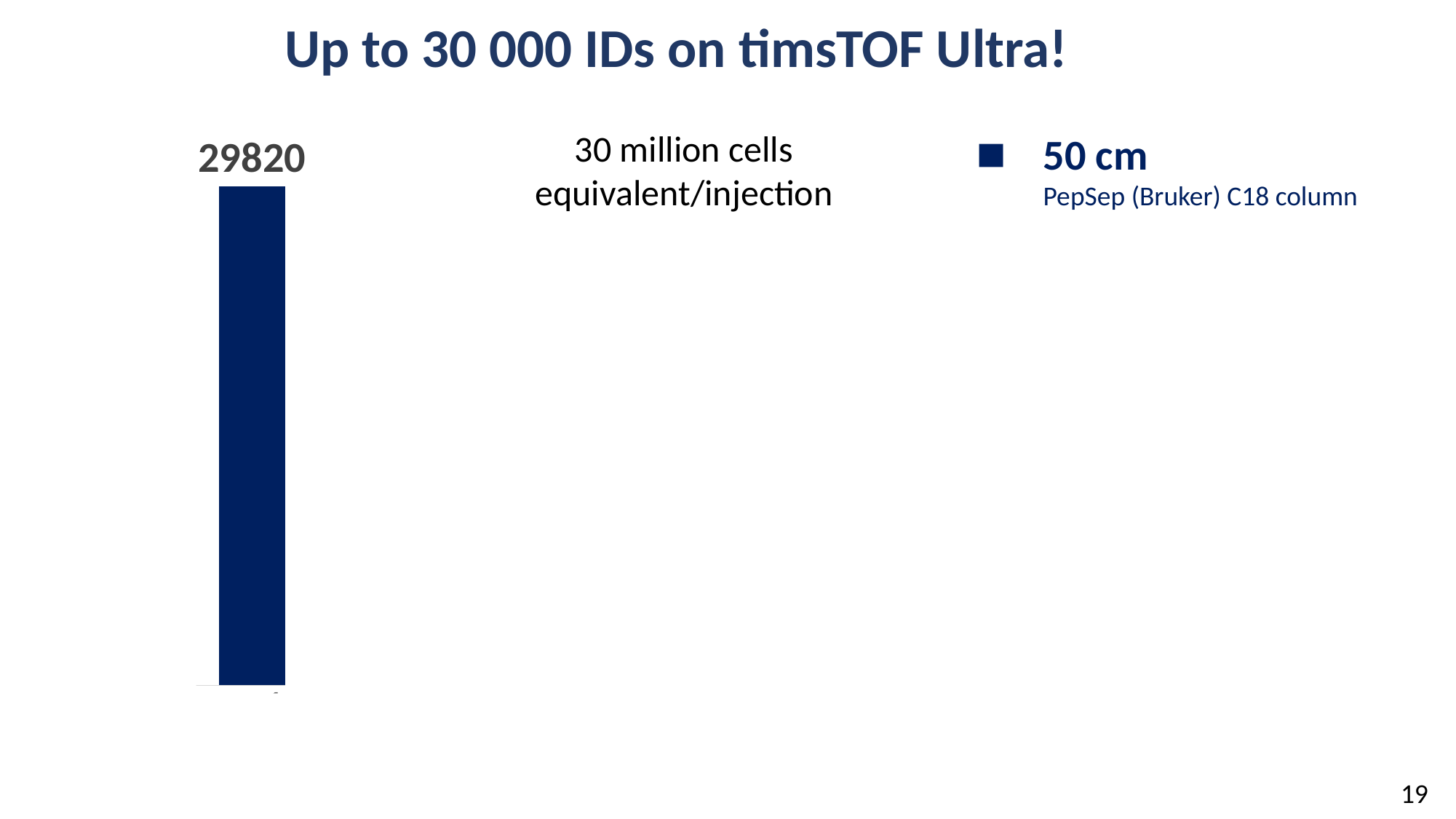
What is the title of the slide containing the chart? Up to 30 000 IDs on timsTOF Ultra! What value is printed above the bar in the chart? 29820 What is the value of the bar for the 50 cm series? 29820 How many bars are plotted in the chart? 1 Is the value of the bar greater or less than 30 000? less What kind of chart is shown on the slide? bar chart